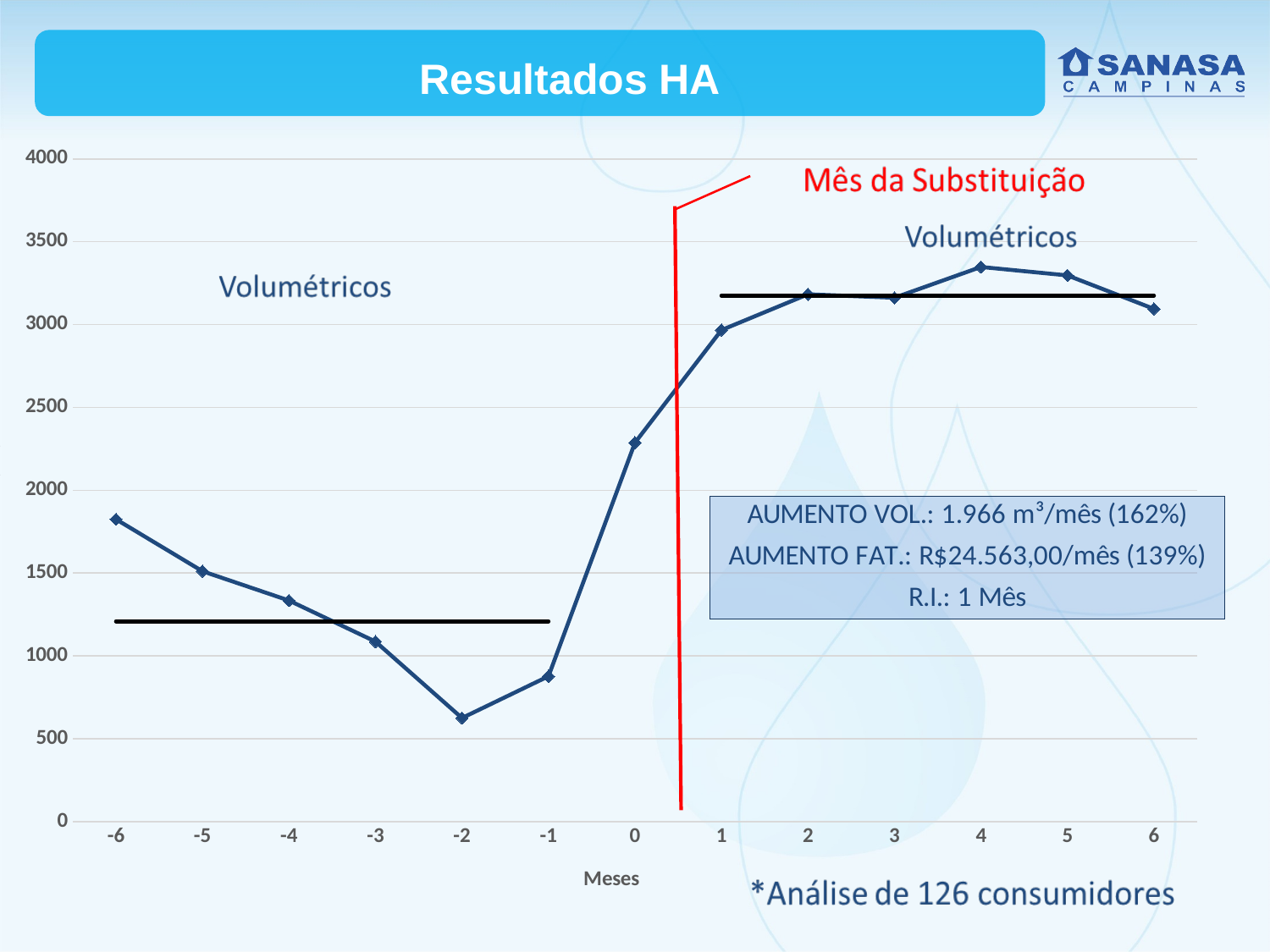
Is the value for month 4 greater or less than 3000? greater What kind of chart is shown on the slide? line chart Is the value for month 0 greater or less than 2000? greater Do the values rise or fall from month -6 to month -2? fall Which month has the lowest value on the line? -2 What label is attached to the red vertical line on the chart? Mês da Substituição What is the title of the x axis? Meses Is the value for month -6 greater or less than 1500? greater Which is larger, the value for month 0 or the value for month -1? month 0 How many data points are plotted on the line, from month -6 to month 6? 13